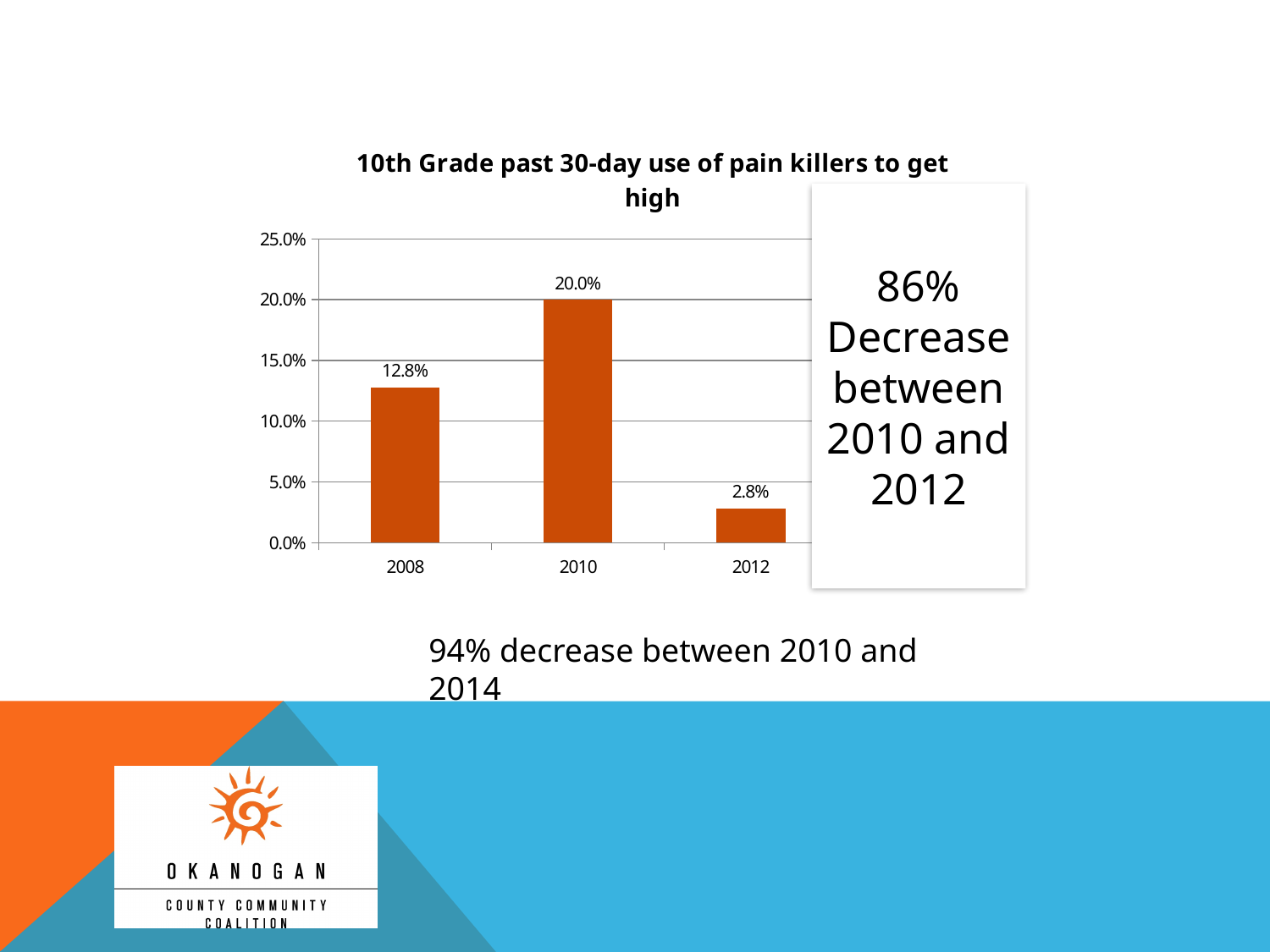
Which year has the lowest value? 2012 Which year has the highest value? 2010 What is the difference between the values for 2010 and 2008? 7.2% What is the value for 2010? 20.0% What is the title of the chart? 10th Grade past 30-day use of pain killers to get high Which is larger, the value for 2008 or the value for 2012? 2008 What kind of chart is shown on the slide? bar chart What is the value for 2008? 12.8% What is the difference between the values for 2010 and 2012? 17.2% Is the value for 2008 greater or less than 10.0%? greater How many years are shown on the x axis? 3 What is the value for 2012? 2.8%